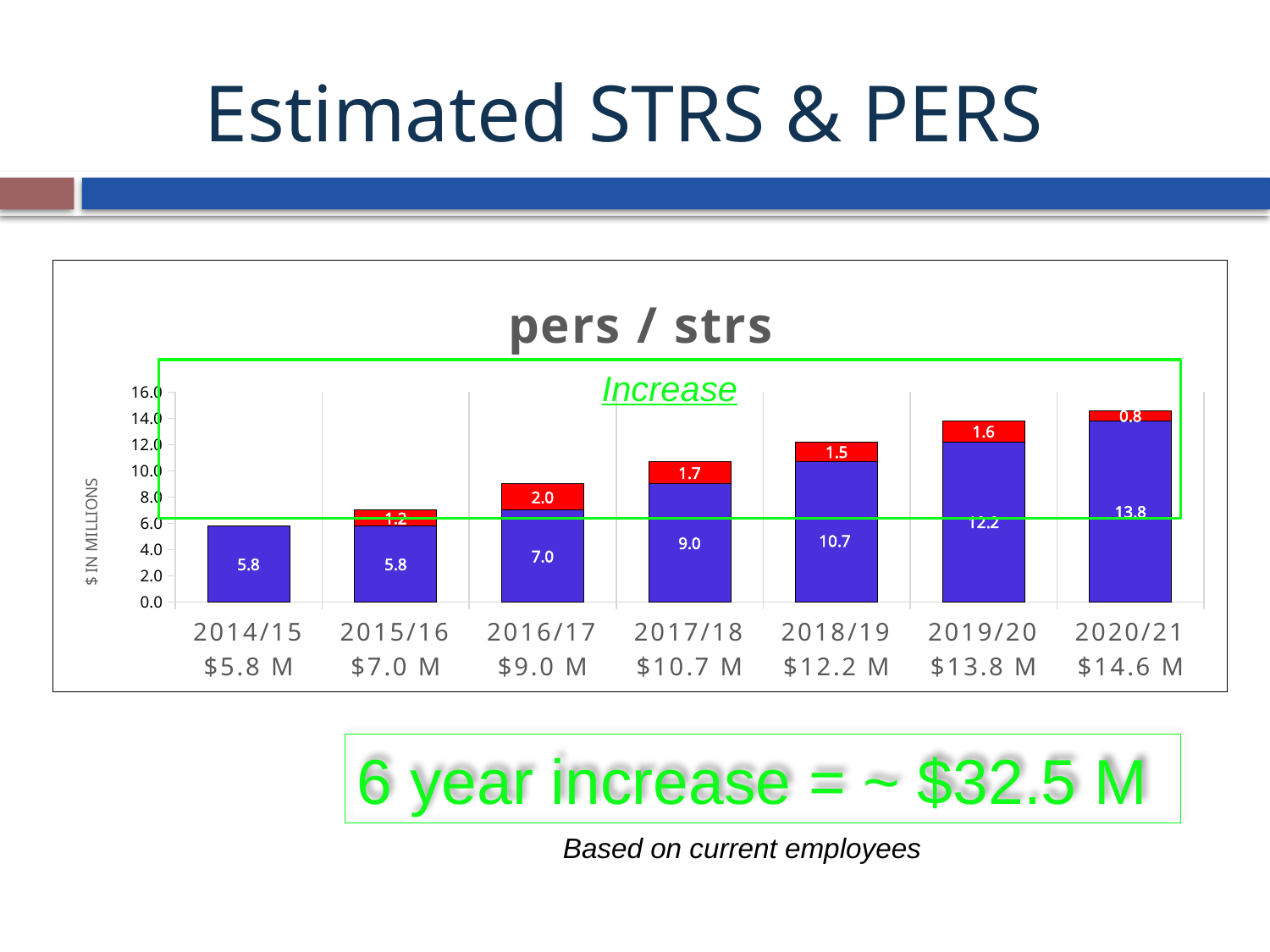
What is the difference between the blue segment values for 2019/20 and 2018/19? 1.5 What is the total of the stacked bar for 2015/16 (blue plus red)? 7.0 What is the title of the chart? pers / strs Which year has the largest red increase segment? 2016/17 Is the red increase segment larger for 2017/18 or for 2018/19? 2017/18 What is the value of the blue segment for 2017/18? 9.0 Do the total bar heights rise or fall from 2014/15 to 2020/21? Rise Which year has the smallest red increase segment among those with a red segment? 2020/21 What is the total shown for 2020/21 below the x axis? $14.6 M What type of chart is shown on the slide? Stacked bar chart What is the value of the red increase segment for 2016/17? 2.0 How many fiscal years are shown on the x axis of the chart? 7